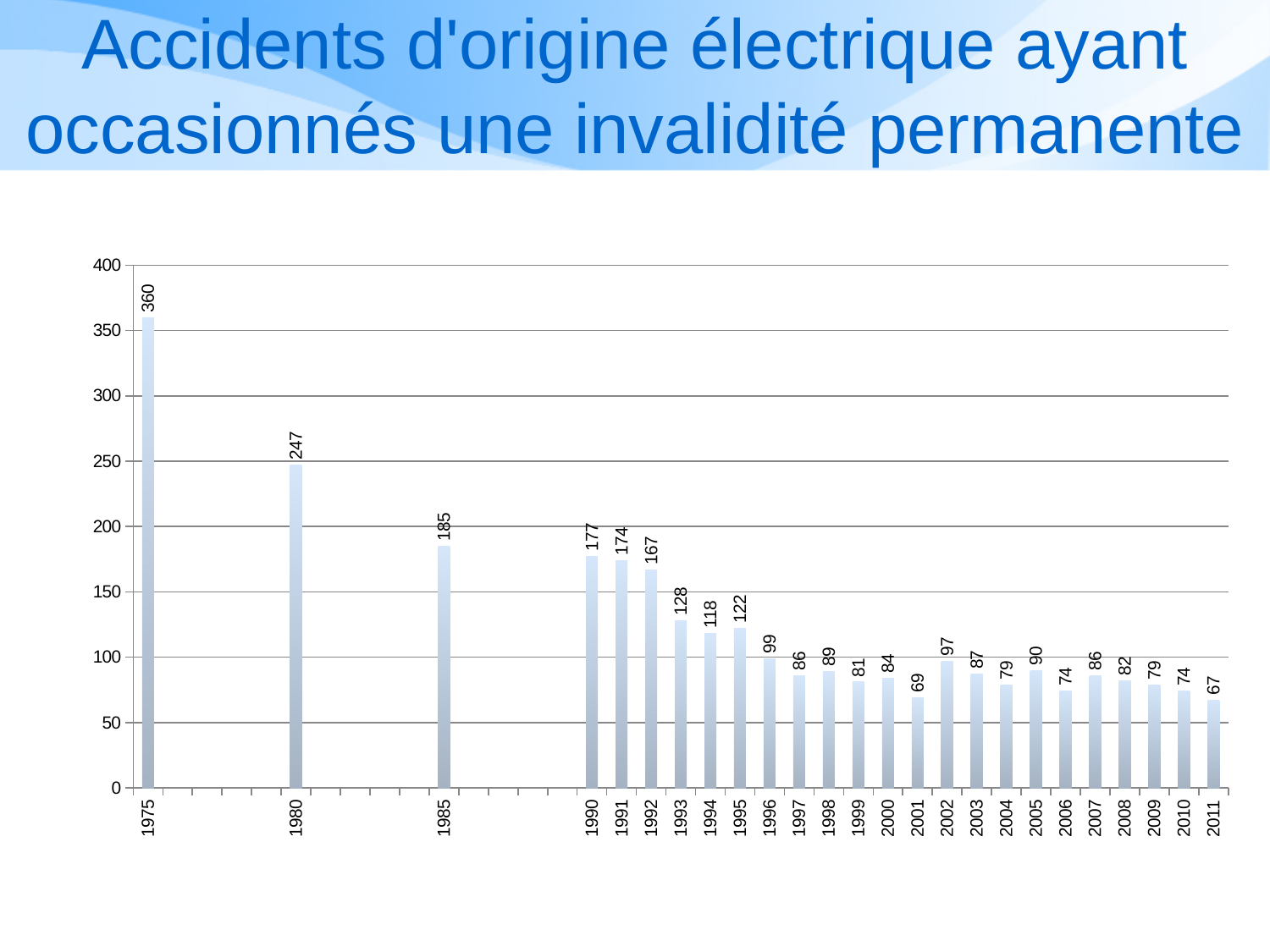
Which year has the lowest value? 2011 Do the values generally rise or fall from 1975 to 2011? fall How many bars are plotted on the chart? 25 What kind of chart is shown on the slide? bar chart What is the difference between the values for 1990 and 2011? 110 What is the value for 2011? 67 What is the difference between the values for 1975 and 1980? 113 What is the value for 2002? 97 What is the value for 1993? 128 Which year has the highest value? 1975 Which is larger, the value for 1994 or the value for 1995? 1995 What is the value for 1975? 360